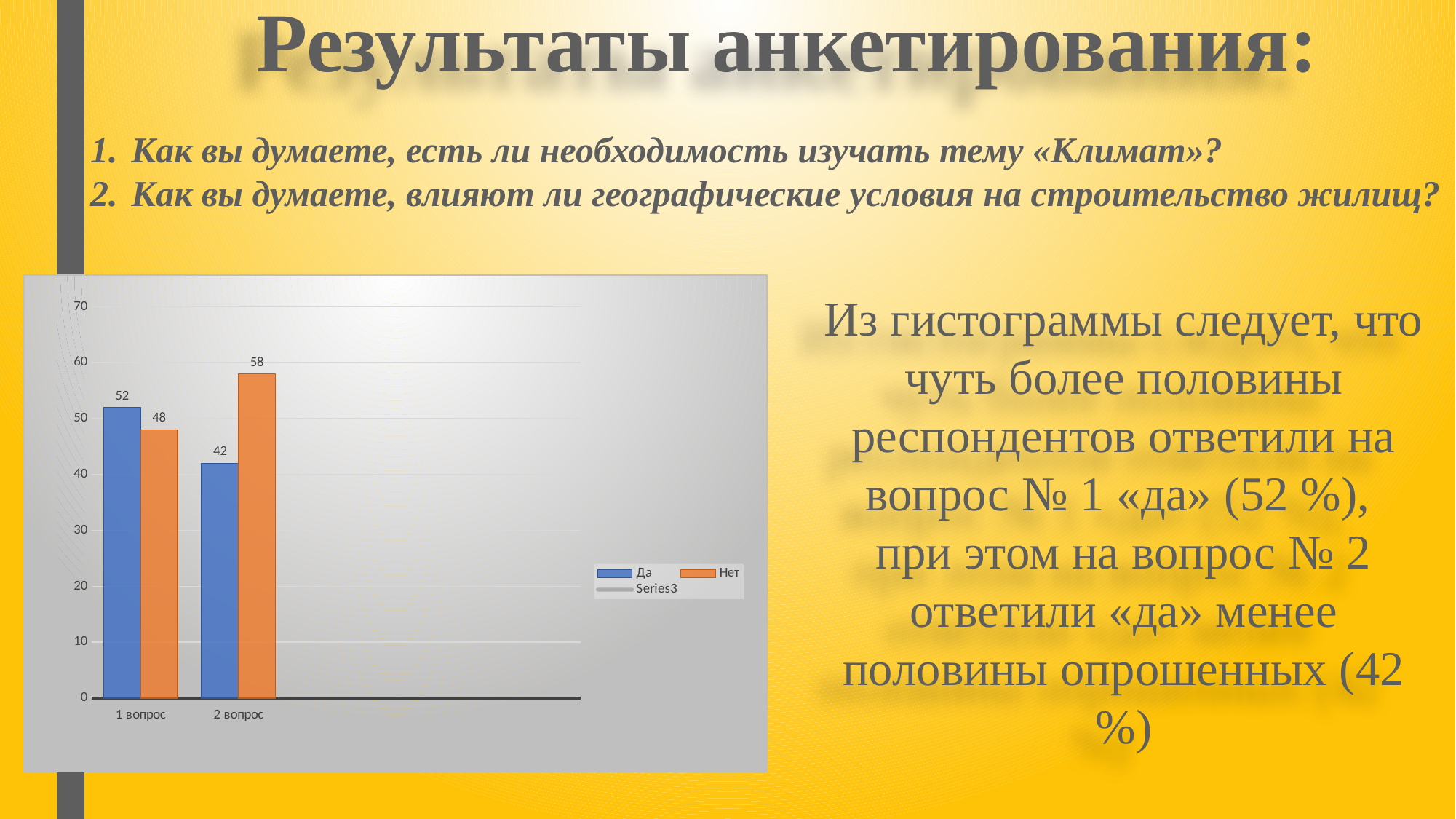
Which category has the lowest "Да" value? 2 вопрос How many categories are shown on the x axis of the chart? 2 What is the value of the "Да" series for "1 вопрос"? 52 What is the value of the "Нет" series for "1 вопрос"? 48 What type of chart is shown on the slide? Bar chart Which colour represents the "Нет" series in the chart? Orange How many series does the chart legend list? 3 For "1 вопрос", which is larger: the "Да" value or the "Нет" value? Да What is the value of the "Нет" series for "2 вопрос"? 58 What is the difference between the "Нет" and "Да" values for "2 вопрос"? 16 Which category has the highest "Нет" value? 2 вопрос What is the value of the "Да" series for "2 вопрос"? 42